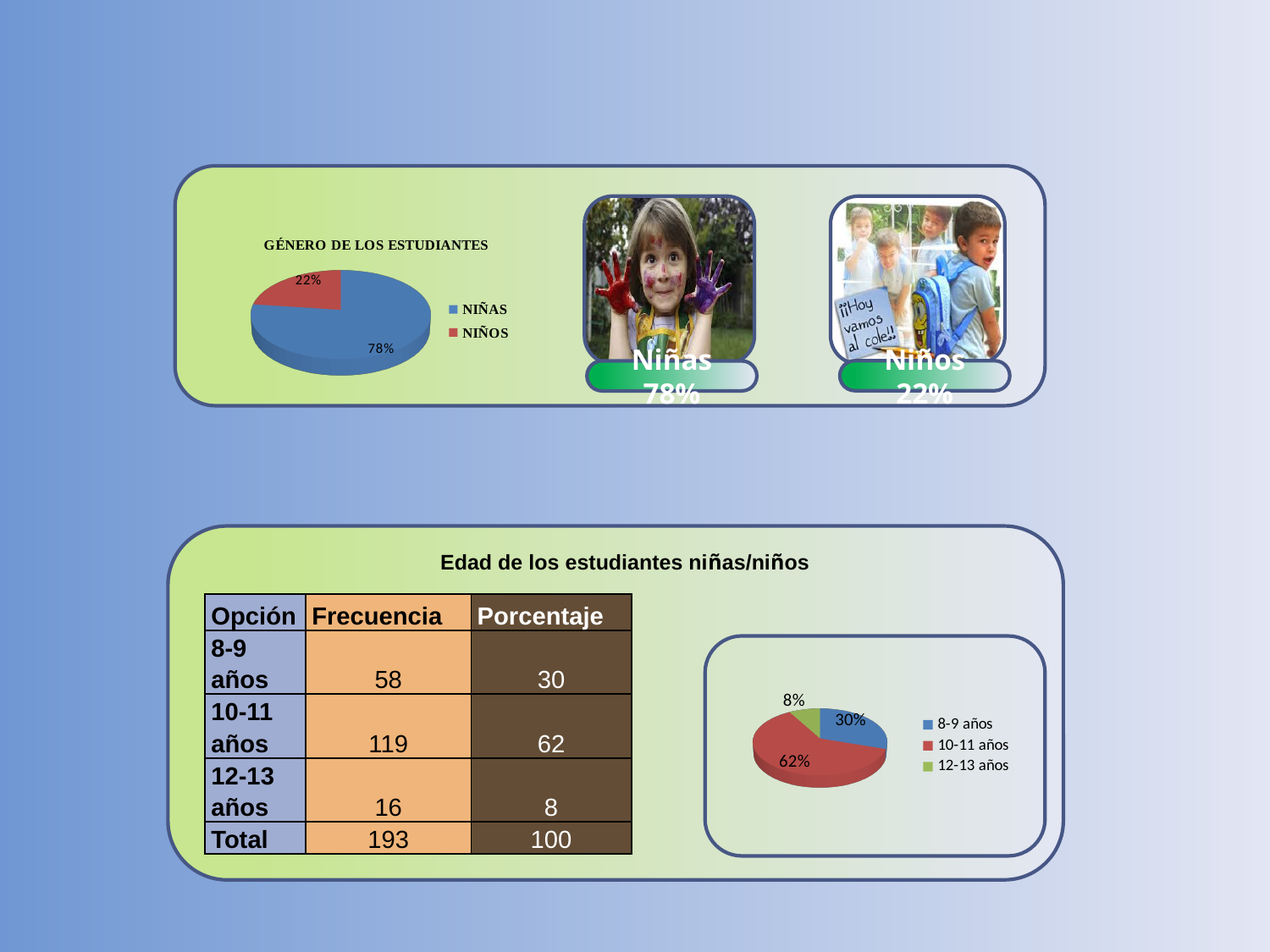
In the pie chart at the lower right of the slide, which age group has the largest share? 10-11 años In the pie chart at the lower right of the slide, how many age groups are shown? 3 In the pie chart at the lower right of the slide, what percentage is shown for 10-11 años? 62% In the 'GÉNERO DE LOS ESTUDIANTES' chart, what percentage is shown for NIÑOS? 22% In the 'GÉNERO DE LOS ESTUDIANTES' chart, what is the difference in percentage points between NIÑAS and NIÑOS? 56 How many entries does the legend of the 'GÉNERO DE LOS ESTUDIANTES' chart list? 2 In the pie chart at the lower right of the slide, what percentage is shown for 8-9 años? 30% In the 'GÉNERO DE LOS ESTUDIANTES' chart, what percentage is shown for NIÑAS? 78% In the 'GÉNERO DE LOS ESTUDIANTES' chart, which category has the larger share? NIÑAS In the pie chart at the lower right of the slide, which age group has the smallest share? 12-13 años In the pie chart at the lower right of the slide, which is larger: the share for 8-9 años or the share for 12-13 años? 8-9 años What type of chart is the 'GÉNERO DE LOS ESTUDIANTES' chart? Pie chart